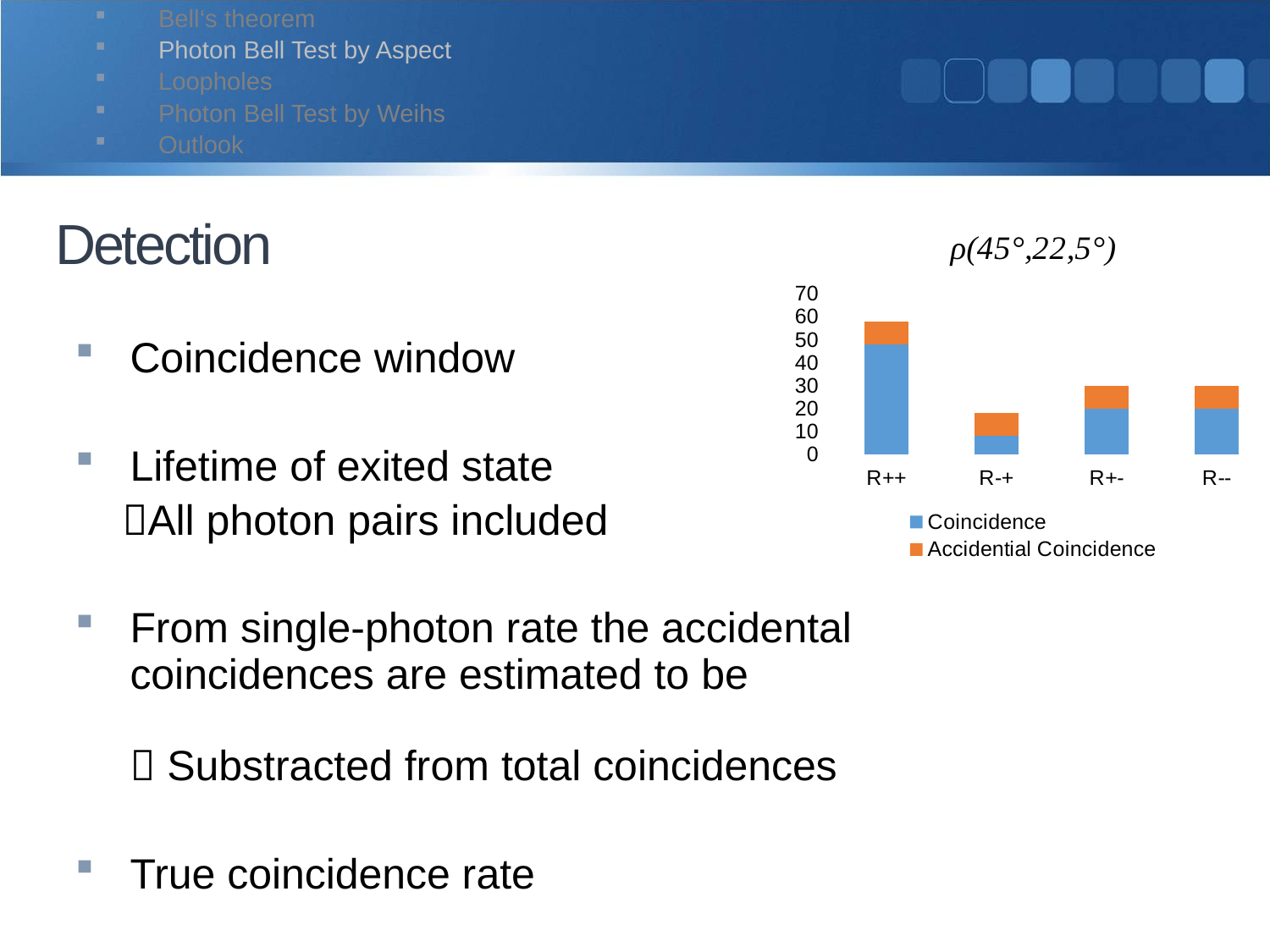
What is the title of the chart? ρ(45°,22,5°) What kind of chart is shown on the slide? stacked bar chart Which category has the tallest stacked bar in the chart? R++ Which category has the shortest stacked bar in the chart? R-+ Is the Coincidence value for R-+ greater or less than 20? less How many series does the chart legend list? 2 Which has the larger total stacked bar, R++ or R--? R++ How many categories are shown on the x axis of the chart? 4 Is the total stacked bar for R+- greater or less than 20? greater Is the Coincidence value for R++ greater or less than 40? greater Which colour represents the Accidential Coincidence series in the chart? orange